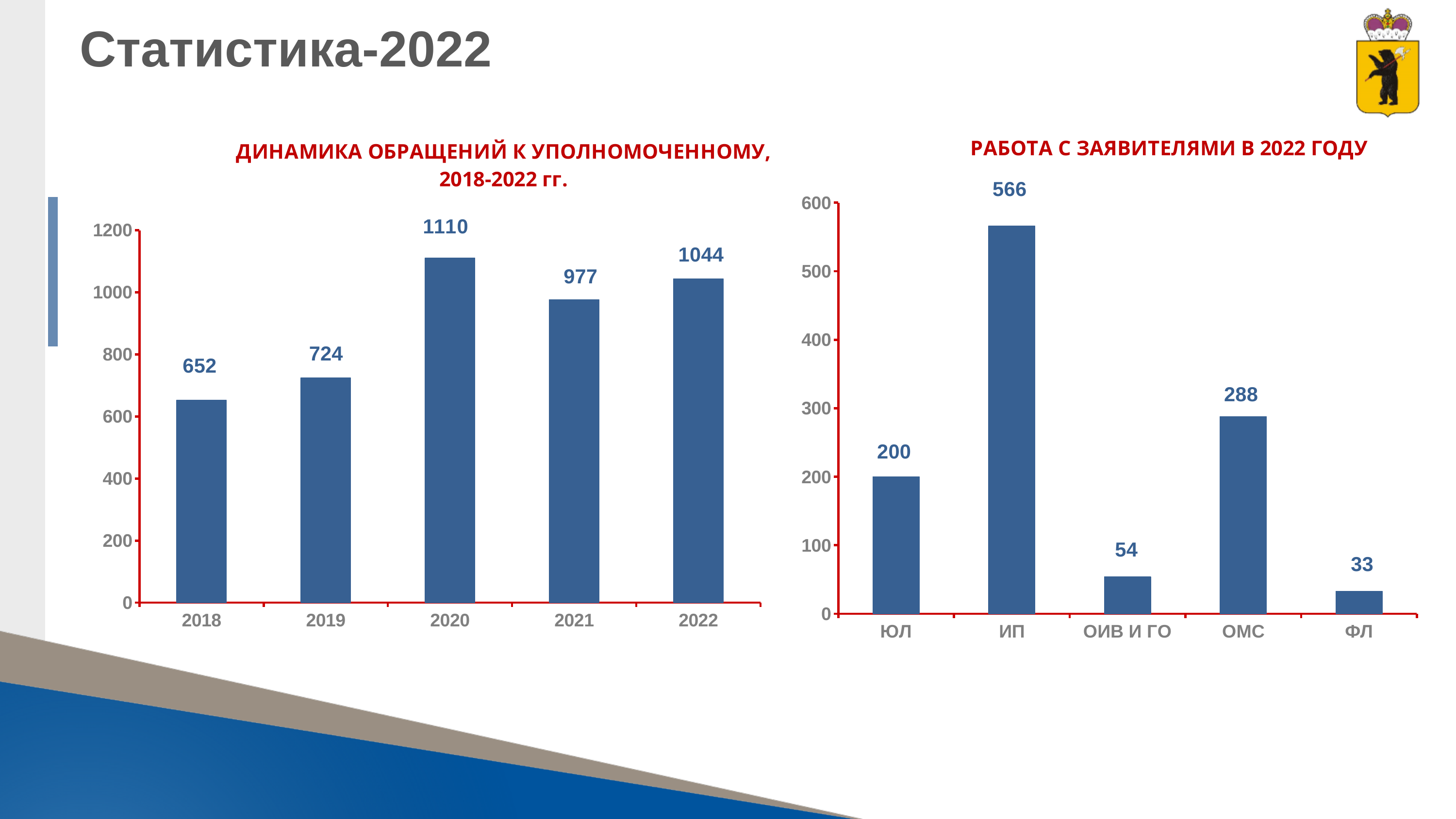
In the left chart (ДИНАМИКА ОБРАЩЕНИЙ К УПОЛНОМОЧЕННОМУ, 2018-2022 гг.), what is the difference between the values for 2022 and 2021? 67 In the left chart (ДИНАМИКА ОБРАЩЕНИЙ К УПОЛНОМОЧЕННОМУ, 2018-2022 гг.), do the values rise or fall from 2018 to 2020? rise In the left chart (ДИНАМИКА ОБРАЩЕНИЙ К УПОЛНОМОЧЕННОМУ, 2018-2022 гг.), which year has the lowest value? 2018 In the left chart (ДИНАМИКА ОБРАЩЕНИЙ К УПОЛНОМОЧЕННОМУ, 2018-2022 гг.), is the value for 2019 greater or less than 800? less In the right chart (РАБОТА С ЗАЯВИТЕЛЯМИ В 2022 ГОДУ), which is larger, the value for ЮЛ or the value for ОИВ И ГО? ЮЛ In the right chart (РАБОТА С ЗАЯВИТЕЛЯМИ В 2022 ГОДУ), which category has the highest value? ИП In the right chart (РАБОТА С ЗАЯВИТЕЛЯМИ В 2022 ГОДУ), what is the value for ОМС? 288 In the right chart (РАБОТА С ЗАЯВИТЕЛЯМИ В 2022 ГОДУ), which category has the lowest value? ФЛ In the right chart (РАБОТА С ЗАЯВИТЕЛЯМИ В 2022 ГОДУ), what is the difference between the values for ИП and ЮЛ? 366 What kind of chart is the right chart (РАБОТА С ЗАЯВИТЕЛЯМИ В 2022 ГОДУ)? bar chart In the left chart (ДИНАМИКА ОБРАЩЕНИЙ К УПОЛНОМОЧЕННОМУ, 2018-2022 гг.), how many years are shown on the x axis? 5 In the left chart (ДИНАМИКА ОБРАЩЕНИЙ К УПОЛНОМОЧЕННОМУ, 2018-2022 гг.), what is the value for 2020? 1110